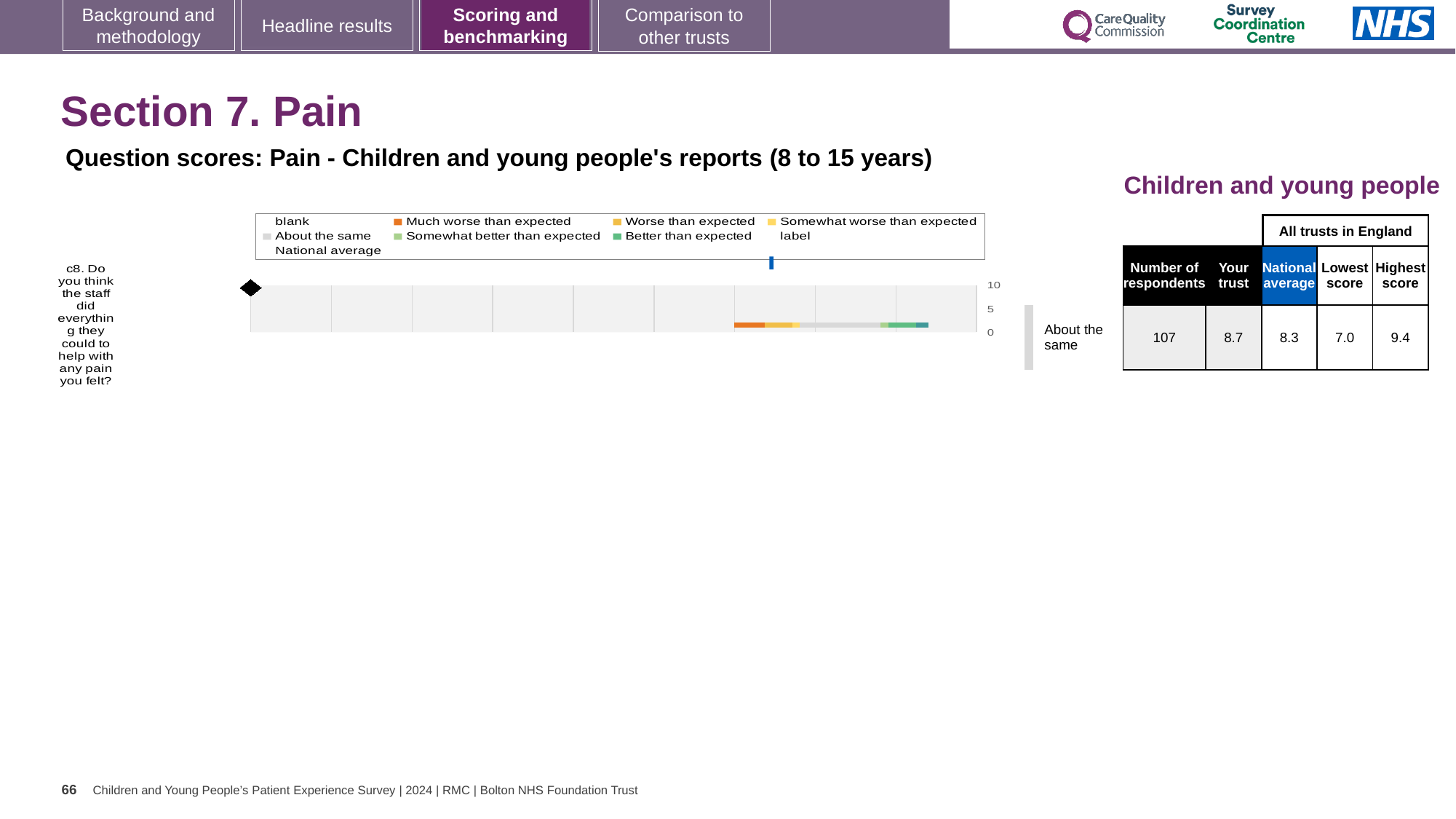
What is the difference between the 'Your trust' score and the national average for question c8? 0.4 What is the national average score for question c8? 8.3 What colour does the legend use for 'Much worse than expected'? orange What is the 'Your trust' score for question c8 in the table? 8.7 Which question is plotted in the chart? c8. Do you think the staff did everything they could to help with any pain you felt? What is the lowest score among all trusts in England for question c8? 7.0 What kind of chart is used to show the question score for c8? bar chart What is the difference between the highest and lowest scores for question c8? 2.4 Which is larger for question c8: the 'Your trust' score or the national average? Your trust What is the highest score among all trusts in England for question c8? 9.4 How many survey questions are plotted in the chart? 1 How many respondents answered question c8? 107